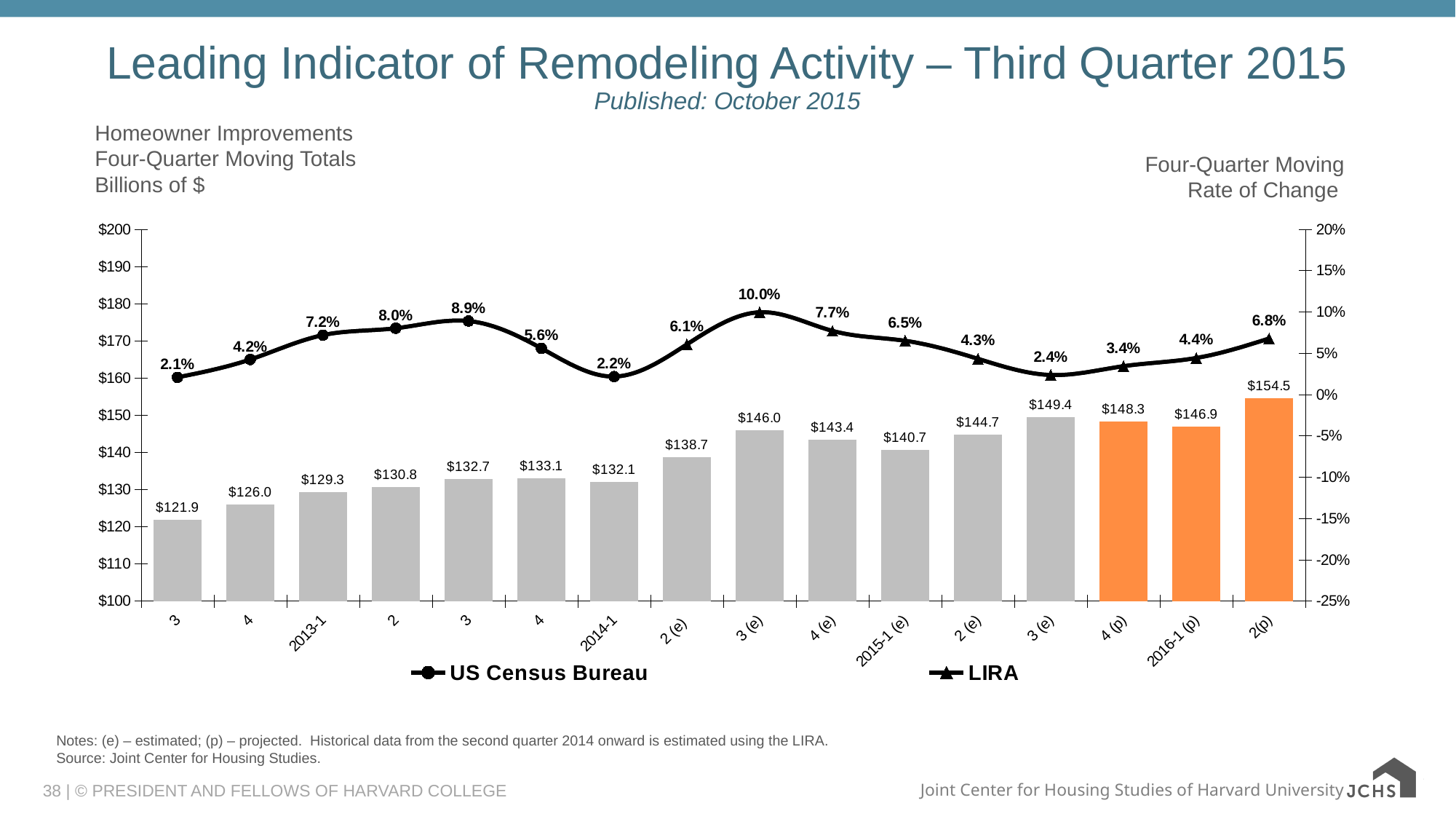
What is the four-quarter moving rate of change shown for 2014-1? 2.2% Which bar is taller, 3 (e) or 4 (e)? 3 (e) What is the lowest rate of change shown on the line? 2.1% What is the highest rate of change shown on the line, and at which category? 10.0% at 3 (e) Which series in the legend uses triangle markers? LIRA What kind of chart is this? Combination bar and line chart How many bars are plotted on the chart? 16 What is the difference between the bar values for 2(p) and 2016-1 (p)? $7.6 Which category has the highest bar? 2(p) What is the four-quarter moving total for 2015-1 (e)? $140.7 What is the value of the leftmost bar (labeled 3)? $121.9 How many series does the legend list? 2